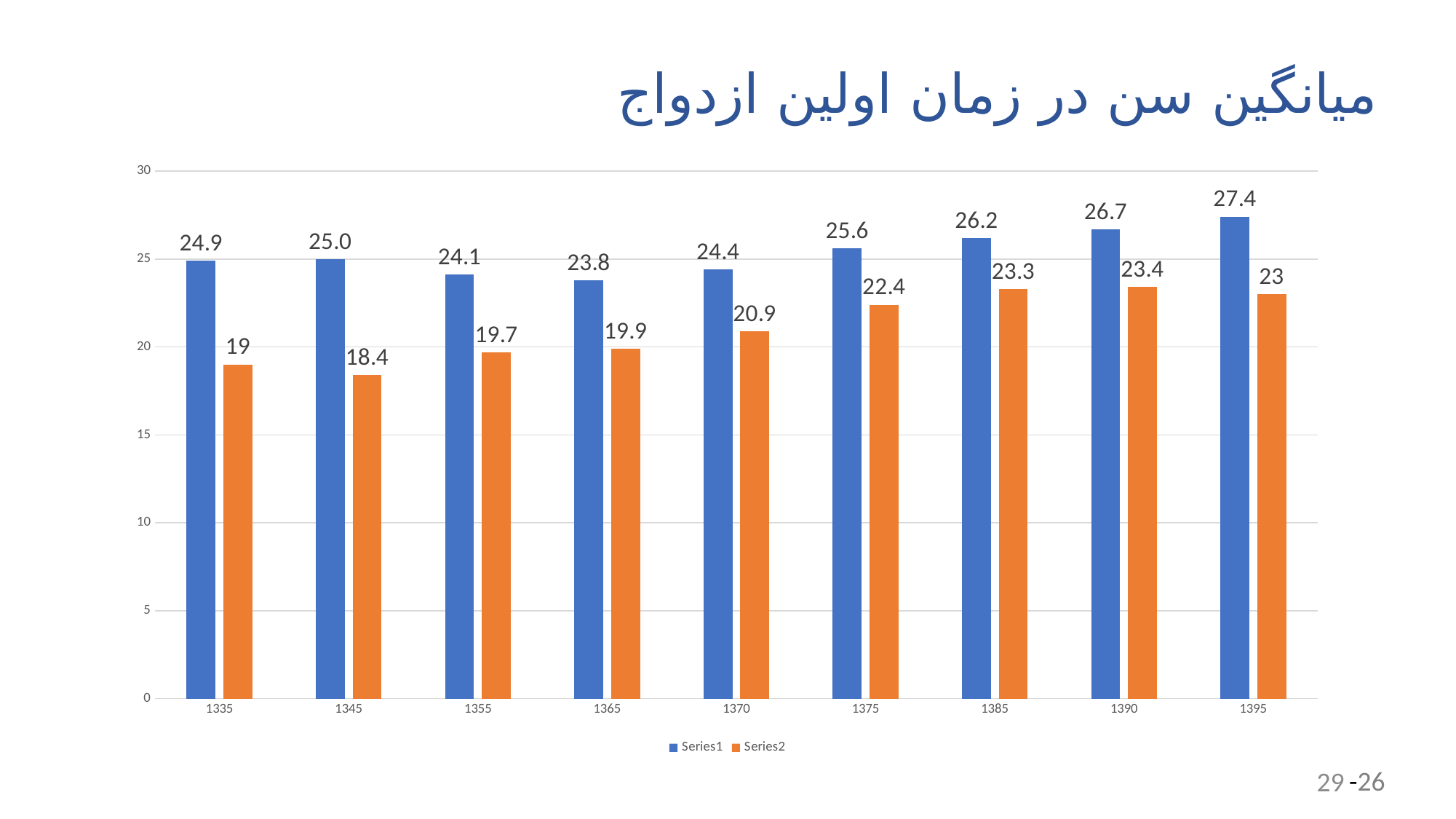
What is the value of Series1 for 1395? 27.4 Is the value of Series2 for 1375 greater or less than 20? greater Do the Series2 values rise or fall from 1370 to 1390? rise What is the value of Series2 for 1345? 18.4 Which category has the highest Series1 value? 1395 Which category has the lowest Series2 value? 1345 How many categories are shown on the x axis? 9 How many series does the legend list? 2 What is the value of Series2 for 1370? 20.9 Which is larger, Series2 for 1390 or Series2 for 1395? Series2 for 1390 What kind of chart is shown on the slide? bar chart What is the difference between Series1 and Series2 for 1335? 5.9